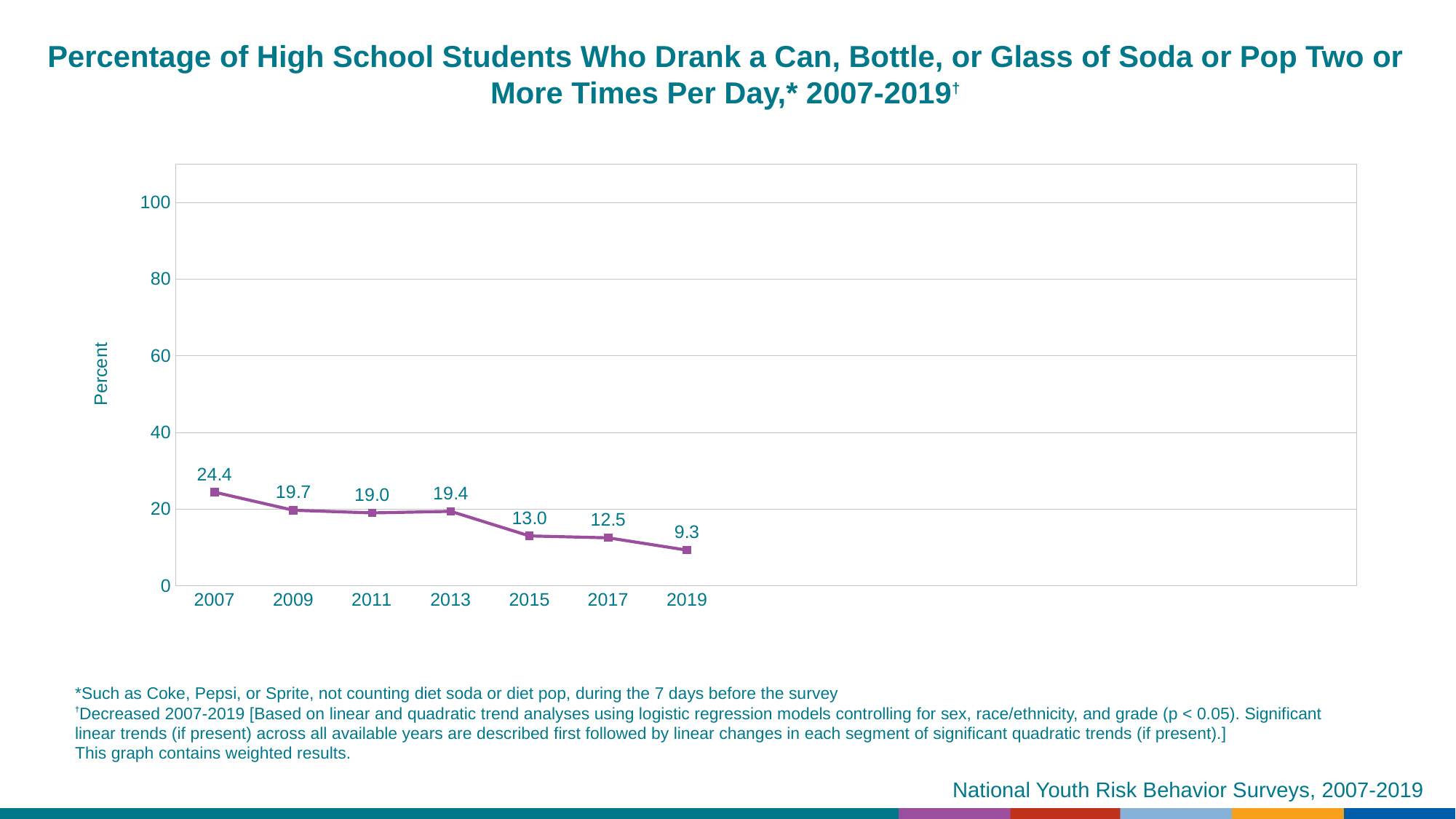
Which year has the lowest value on the chart? 2019 What is the value plotted for 2013? 19.4 What is the difference between the 2007 value and the 2019 value? 15.1 What is the value plotted for 2019? 9.3 Which year has the highest value on the chart? 2007 Is the value for 2007 greater or less than 20? greater Do the values generally rise or fall from 2007 to 2019? fall Which is larger, the value for 2009 or the value for 2011? 2009 What is the difference between the 2013 value and the 2015 value? 6.4 What percentage of high school students drank soda or pop two or more times per day in 2007? 24.4 What kind of chart is shown on the slide? line chart How many years are plotted on the chart? 7